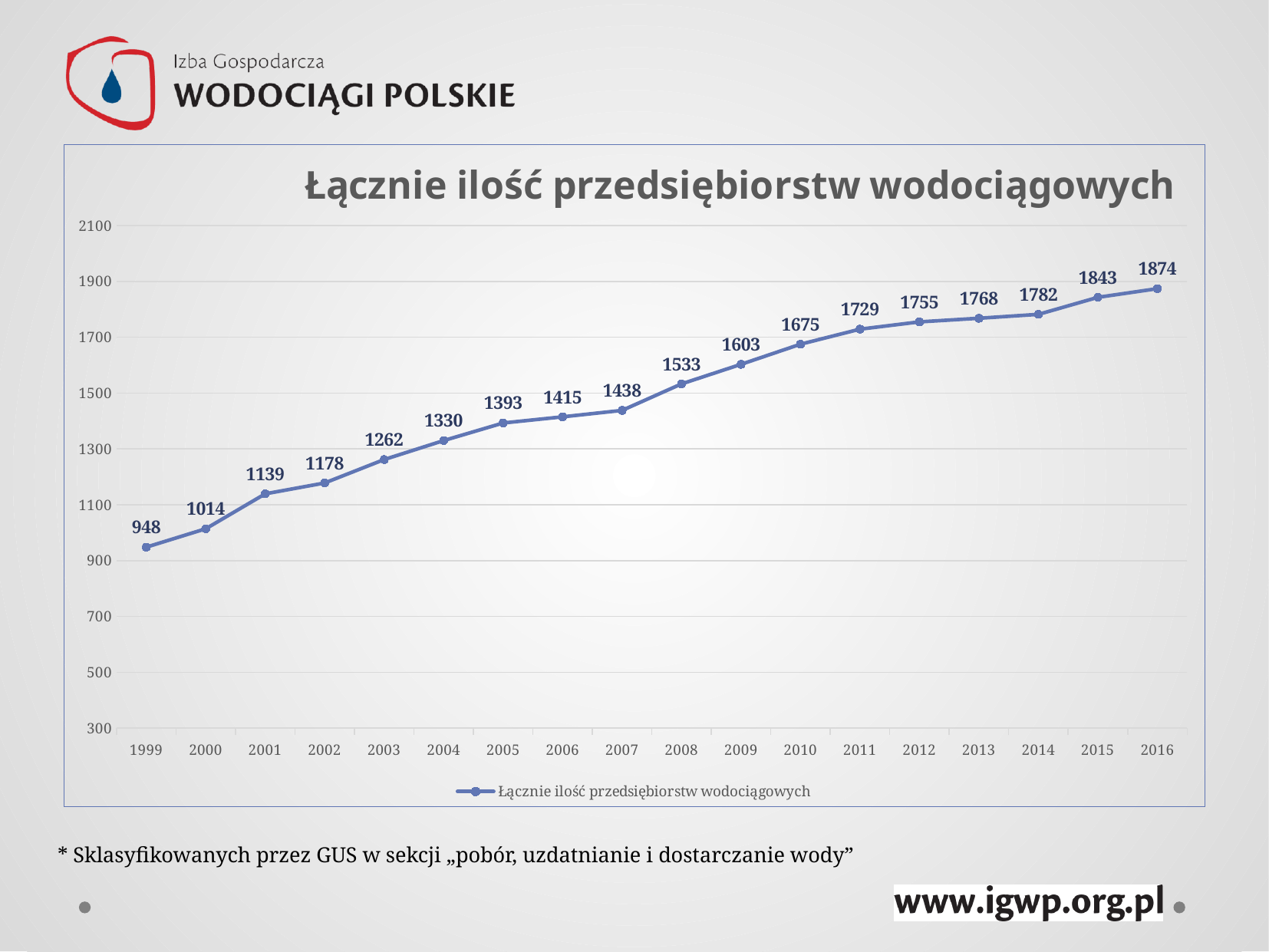
What kind of chart is shown? line chart What is the difference between the values for 2015 and 2014? 61 Do the values rise or fall from 1999 to 2016? rise Which year has the lowest value? 1999 What is the value for 1999? 948 What is the value for 2016? 1874 Which year has the highest value? 2016 Which is larger, the value for 2005 or the value for 2003? 2005 How many years are plotted on the x axis? 18 What is the difference between the values for 2016 and 1999? 926 What is the value for 2008? 1533 Is the value for 2010 greater or less than 1500? greater